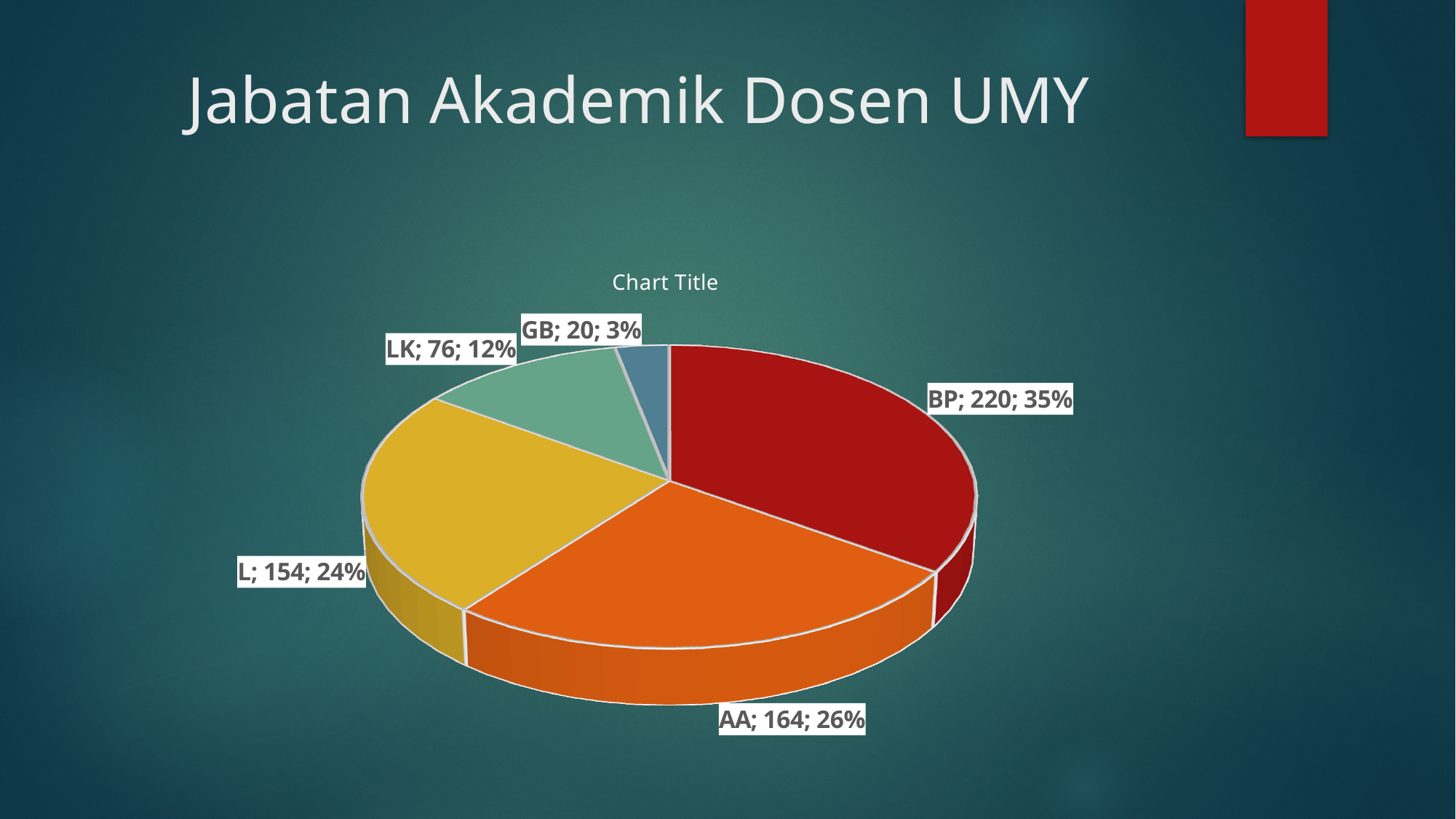
Which is larger, the value for AA or the value for L? AA What is the value for LK? 76 What share of the pie does AA represent? 26% What is the difference between the values for BP and AA? 56 What is the value for BP? 220 Which category has the smallest slice? GB What kind of chart is shown on the slide? Pie chart Which category has the largest slice? BP How many categories does the pie chart show? 5 What is the difference between the values for L and LK? 78 What is the value for GB? 20 What is the title of the slide? Jabatan Akademik Dosen UMY